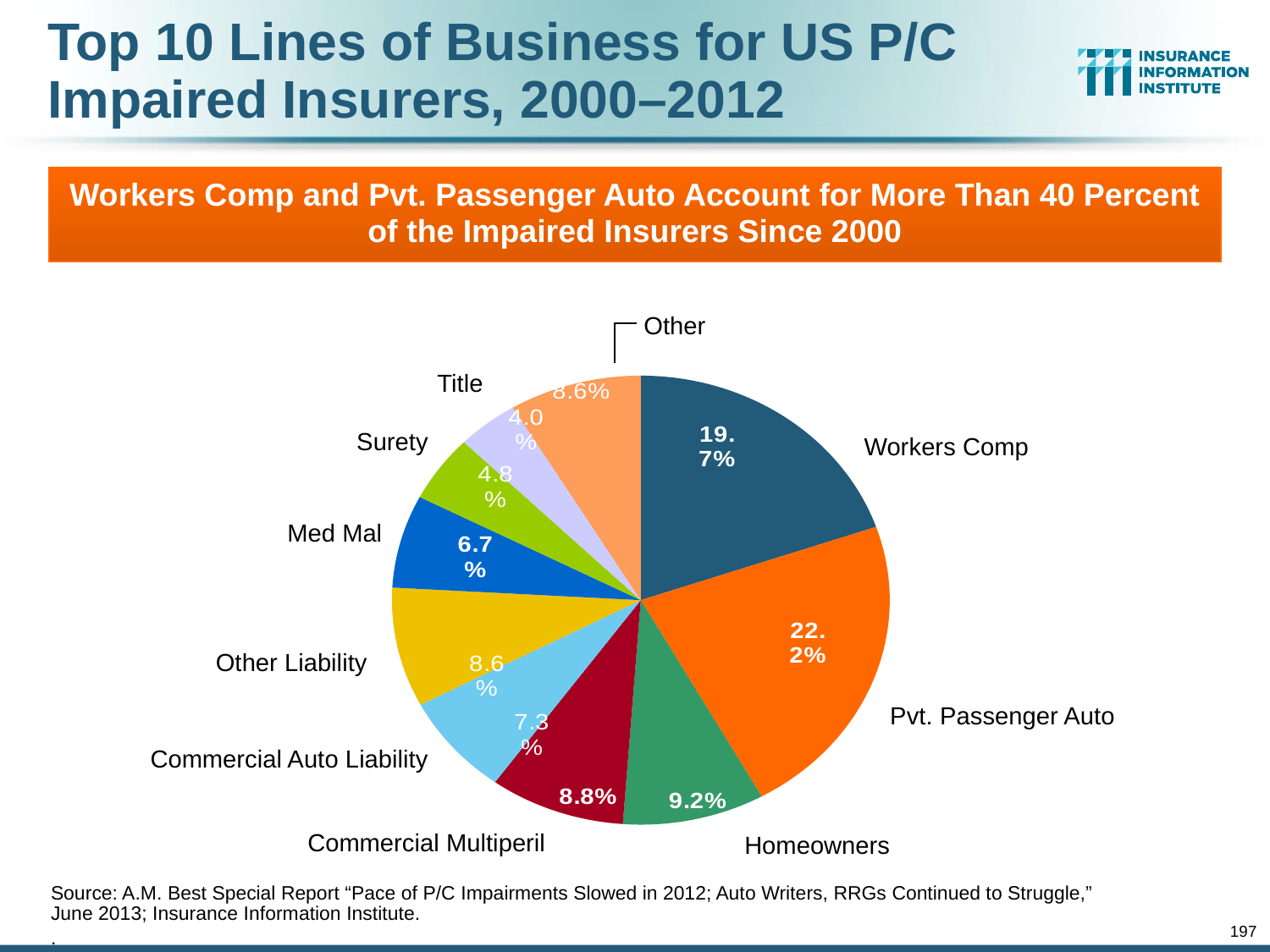
What kind of chart is shown on the slide? pie chart What share of impaired insurers is attributed to Workers Comp? 19.7% How many percentage points larger is the Pvt. Passenger Auto share than the Workers Comp share? 2.5 percentage points What percentage is shown for Surety? 4.8% What percentage is shown for Commercial Auto Liability? 7.3% How many lines of business (slices) are shown in the pie chart? 10 Which line of business has the largest share of the pie? Pvt. Passenger Auto What percentage is shown for Med Mal? 6.7% What percentage is shown for Homeowners? 9.2% Which line of business has the smallest share of the pie? Title What share of impaired insurers is attributed to Pvt. Passenger Auto? 22.2% Which has the larger share, Homeowners or Commercial Multiperil? Homeowners